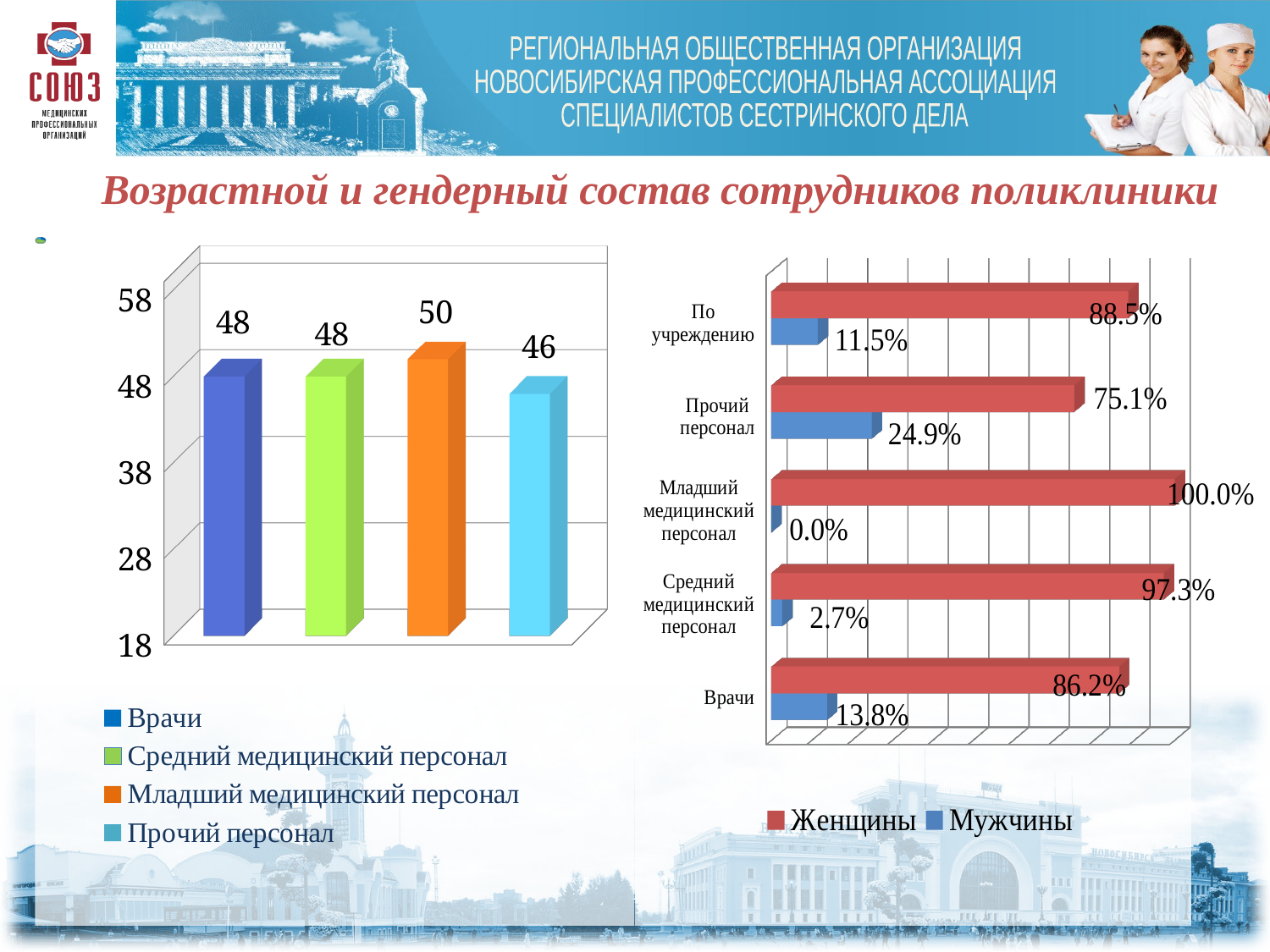
How many bars are plotted in the left chart? 4 In the left chart, which category has the lowest value? Прочий персонал In the right chart, which category has the highest value for Женщины? Младший медицинский персонал In the right chart, what is the value for Женщины in the Врачи category? 86.2% In the right chart, what is the difference between Женщины and Мужчины in the По учреждению category? 77.0% In the left chart, what is the difference between the values for Младший медицинский персонал and Прочий персонал? 4 In the left chart, what is the value for Прочий персонал? 46 In the left chart, what is the value for Младший медицинский персонал? 50 How many series does the legend of the right chart list? 2 In the right chart, what is the value for Мужчины in the Прочий персонал category? 24.9% What type of chart is the right chart? Bar chart In the left chart, which category has the highest value? Младший медицинский персонал